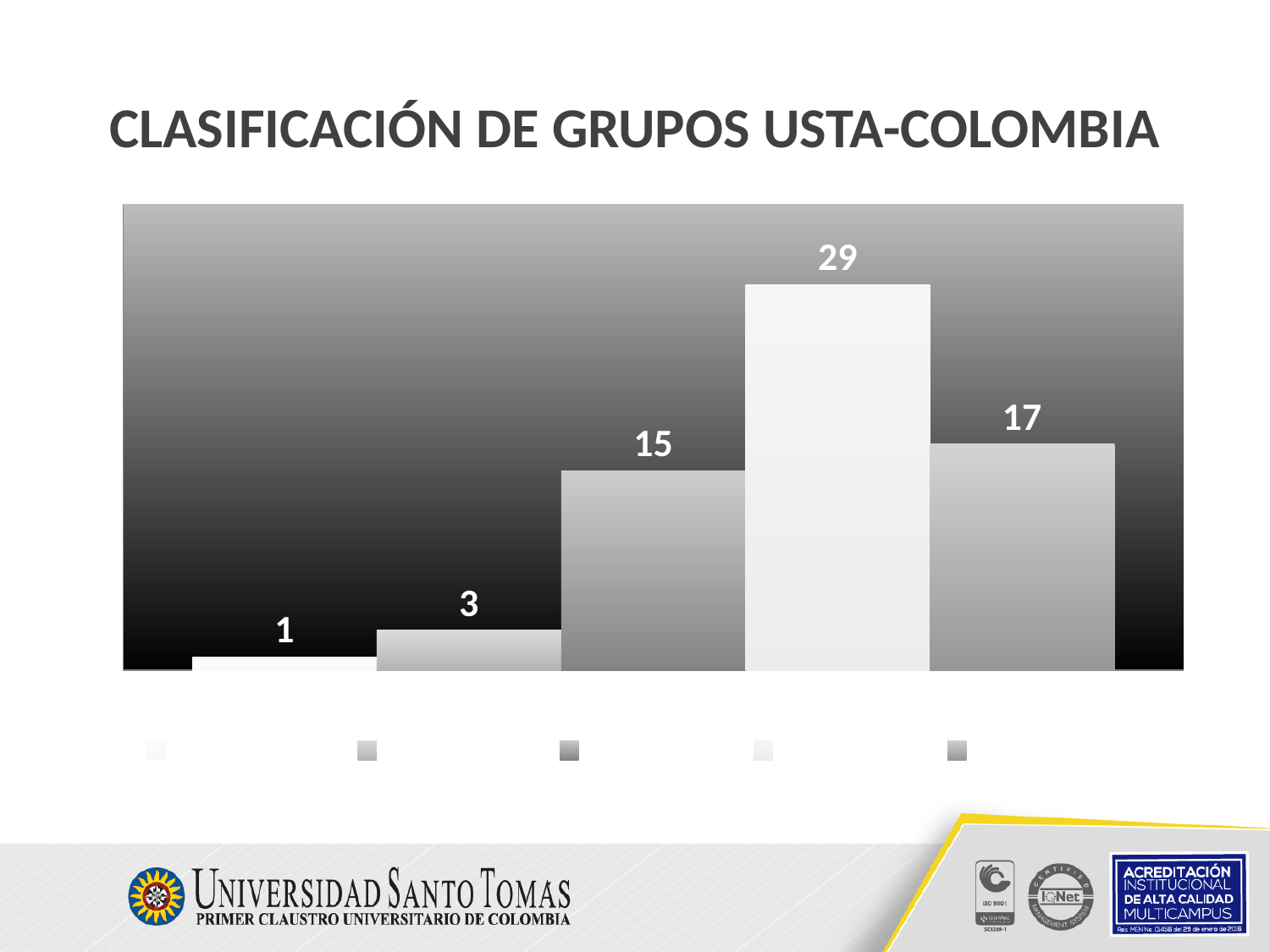
What is the value of the shortest bar in the chart? 1 What is the value shown on the third bar from the left? 15 What is the value shown on the second bar from the left? 3 What is the difference between the fourth bar (29) and the fifth bar (17)? 12 What kind of chart is shown on the slide? bar chart How many bars are plotted in the chart? 5 What is the value shown on the rightmost bar? 17 What is the value of the tallest bar in the chart? 29 What is the sum of all five bar values in the chart? 65 What is the title of the chart on the slide? CLASIFICACIÓN DE GRUPOS USTA-COLOMBIA What is the value shown on the first bar from the left? 1 Which is larger, the third bar from the left or the rightmost bar? the rightmost bar